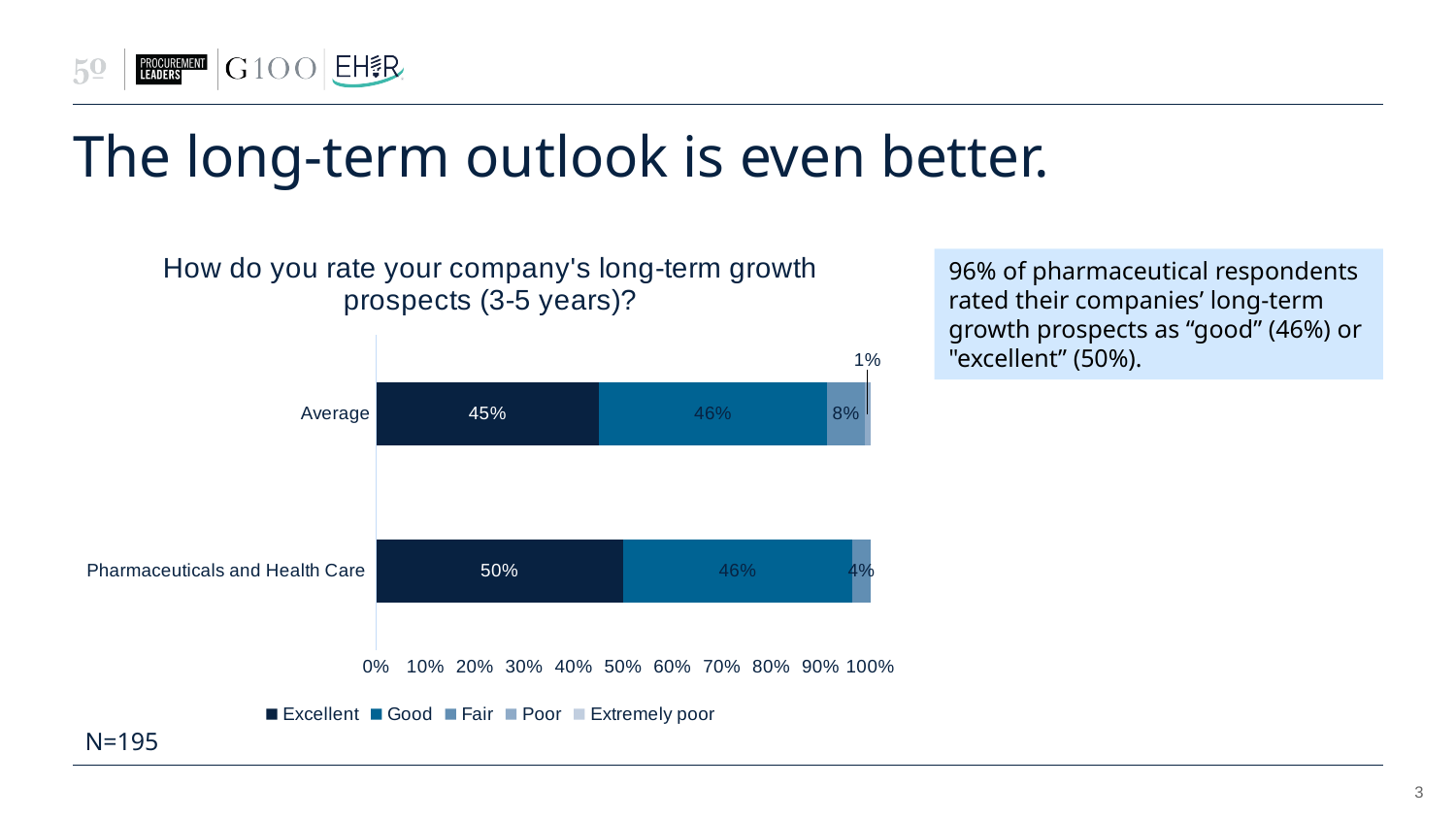
What is the difference between the Fair values for Average and Pharmaceuticals and Health Care? 4% How many series does the legend list? 5 What is the Excellent value for Pharmaceuticals and Health Care? 50% What is the Excellent value for Average? 45% What is the Good value for Average? 46% What is the Fair value for Average? 8% How many categories are shown on the chart? 2 What is the difference between the Excellent values for Pharmaceuticals and Health Care and Average? 5% Which category has the higher Excellent value, Average or Pharmaceuticals and Health Care? Pharmaceuticals and Health Care What is the title of the chart? How do you rate your company's long-term growth prospects (3-5 years)? What is the Fair value for Pharmaceuticals and Health Care? 4% What kind of chart is shown on the slide? Stacked bar chart